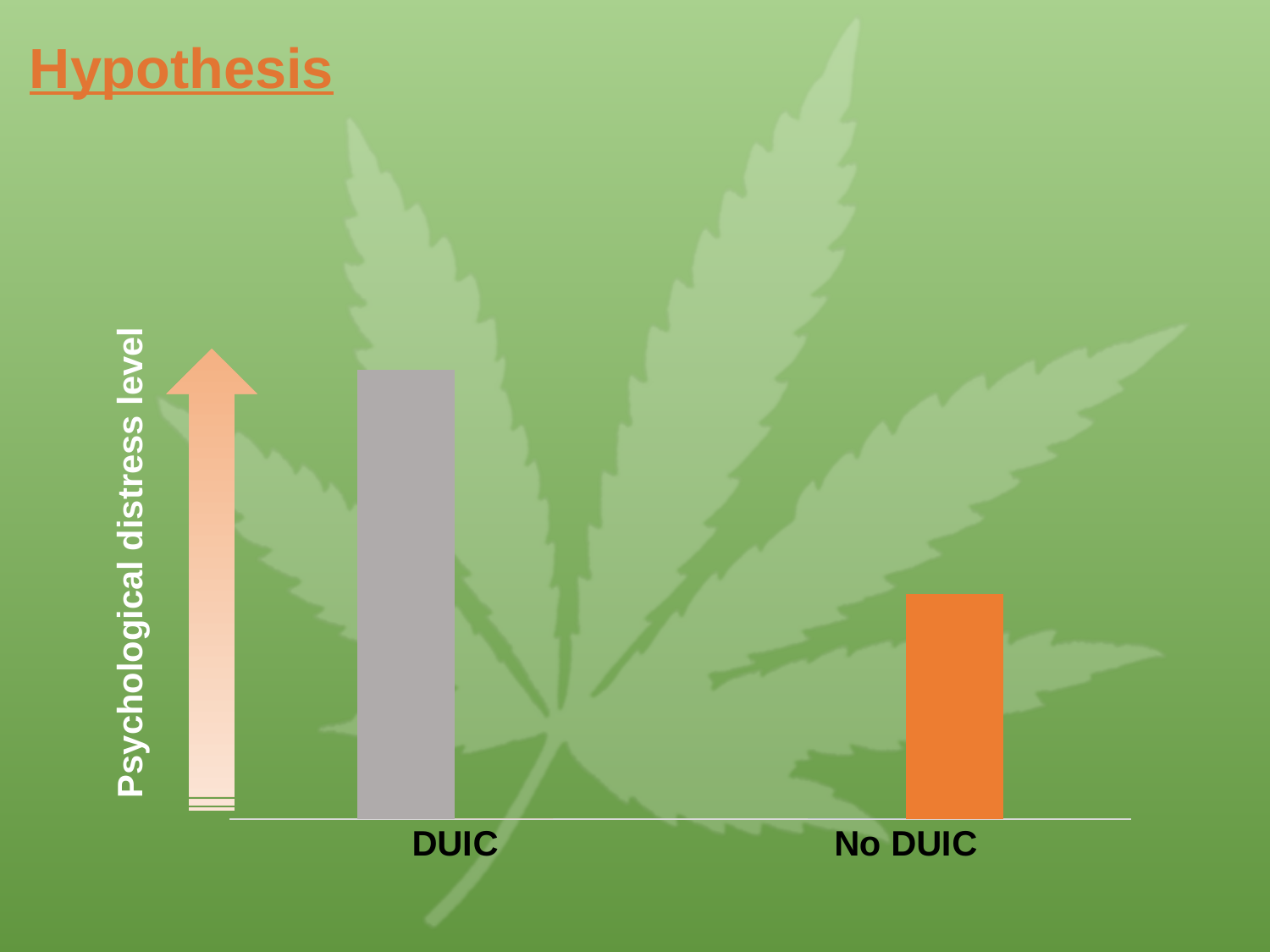
Which category has the highest bar in the chart? DUIC Which bar is taller, DUIC or No DUIC? DUIC What is the label on the vertical axis of the chart? Psychological distress level What colour is the bar for No DUIC? orange How many categories are shown on the x axis of the chart? 2 Which category has the lowest bar in the chart? No DUIC What kind of chart is shown on the slide? bar chart Do the bar heights rise or fall from DUIC to No DUIC along the x axis? fall